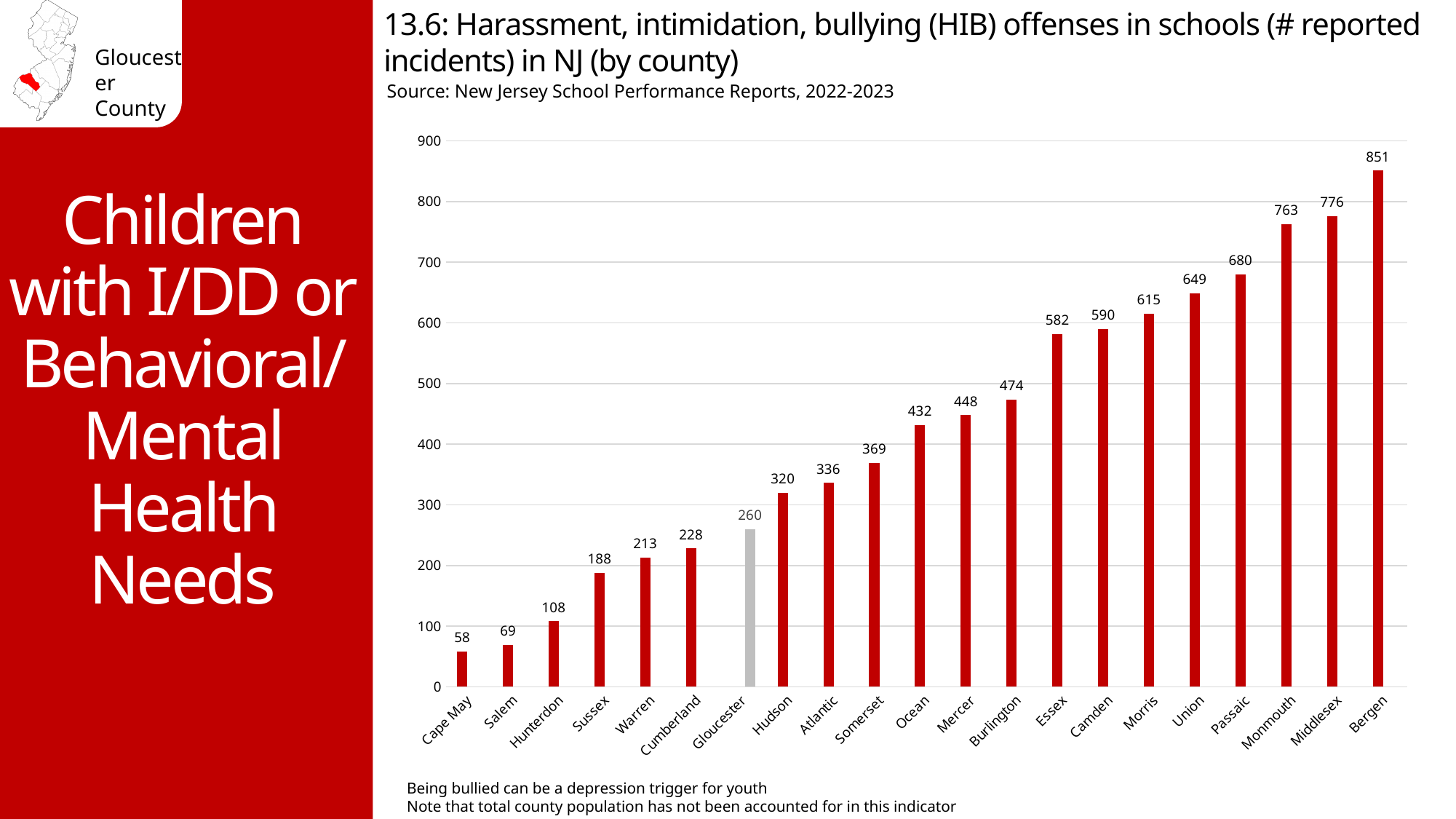
Which county has the highest number of reported HIB incidents? Bergen What is the number of reported HIB incidents for Bergen County? 851 What type of chart is used on this slide? Bar chart How many counties are shown on the chart? 21 Is the value for Hudson greater or less than 300? greater How many HIB incidents were reported for Gloucester County? 260 What is the difference in reported HIB incidents between Bergen and Gloucester? 591 Which county has the lowest number of reported HIB incidents? Cape May Which county's bar is shown in gray rather than red? Gloucester What is the value shown for Cumberland County? 228 Which county has more reported HIB incidents, Camden or Essex? Camden What is the difference between the values for Middlesex and Monmouth? 13